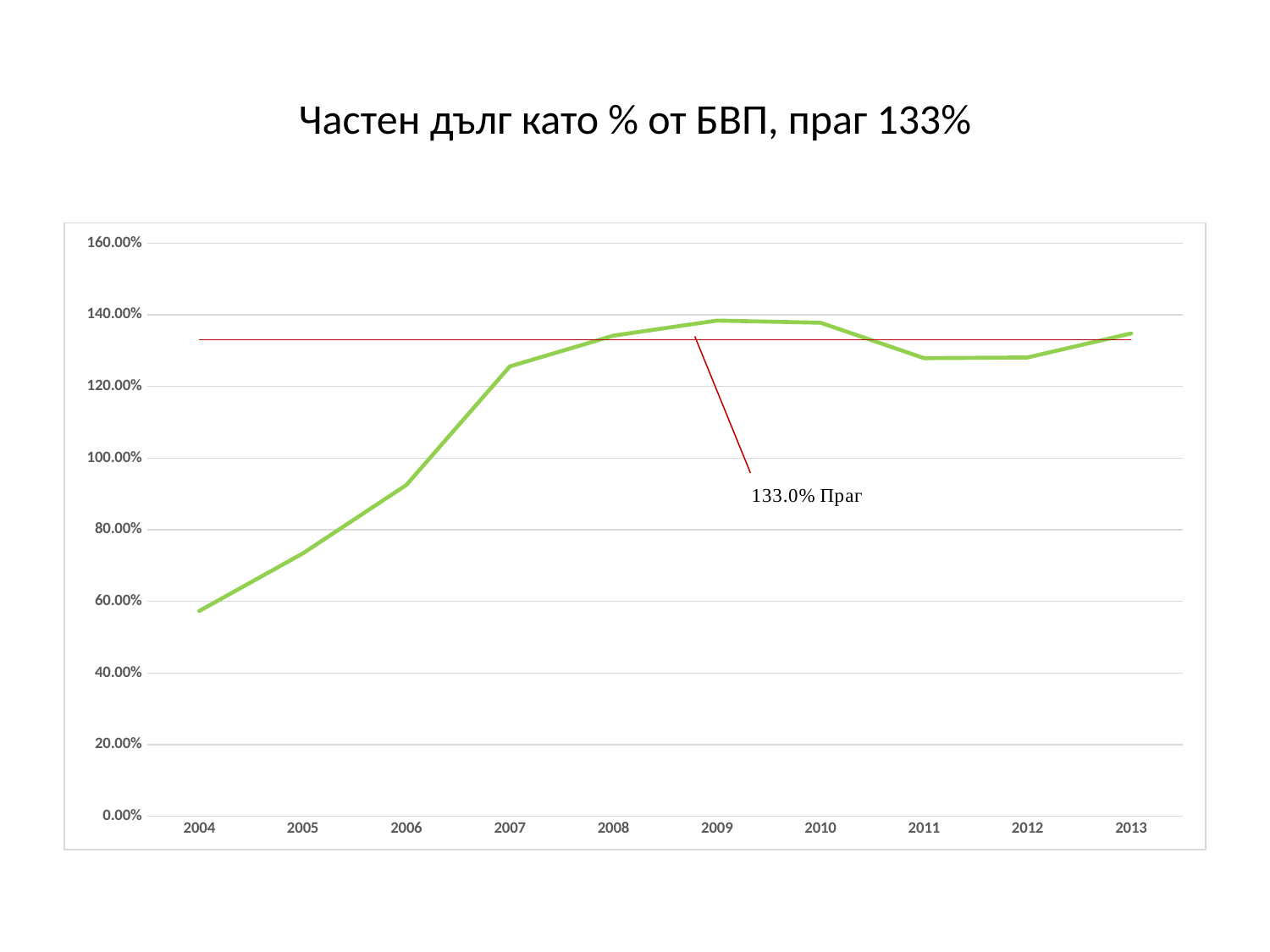
Do the values rise or fall from 2004 to 2009? rise Which year has the lowest value? 2004 What threshold value is labelled by the annotation on the chart? 133.0% Праг What kind of chart is shown on the slide? line chart Is the value for 2009 greater or less than 140.00%? less Is the value for 2007 greater or less than 120.00%? greater Is the value for 2006 greater or less than 100.00%? less What is the title of the slide? Частен дълг като % от БВП, праг 133% Which is larger, the value for 2005 or the value for 2007? 2007 How many years are plotted along the x axis? 10